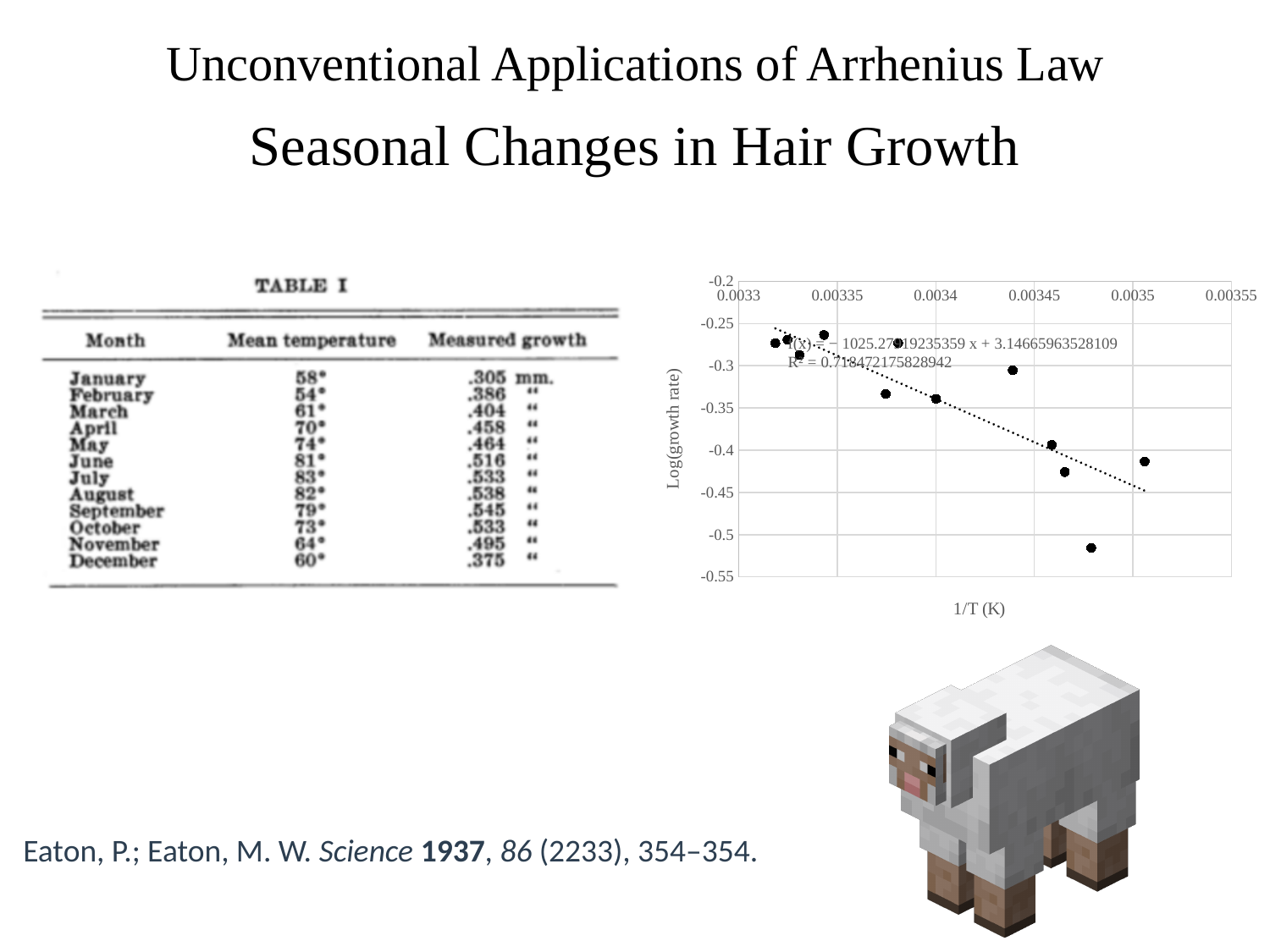
Is the value of the point plotted near 1/T = 0.0034 greater or less than -0.3? less What is the title of the x axis of the chart? 1/T (K) Do the plotted Log(growth rate) values generally rise or fall as 1/T increases? fall What is the intercept of the fitted trendline shown in the chart's equation? 3.14665963528109 Is the value of the point plotted at the largest 1/T (near 0.0035) greater or less than -0.45? greater Which has the higher Log(growth rate): the point plotted near 1/T = 0.00338 or the point plotted near 1/T = 0.00345? the point near 0.00338 What is the title of the y axis of the chart? Log(growth rate) Are the points plotted near 1/T = 0.00332 greater or less than -0.3? greater What kind of chart is shown on the slide? scatter chart